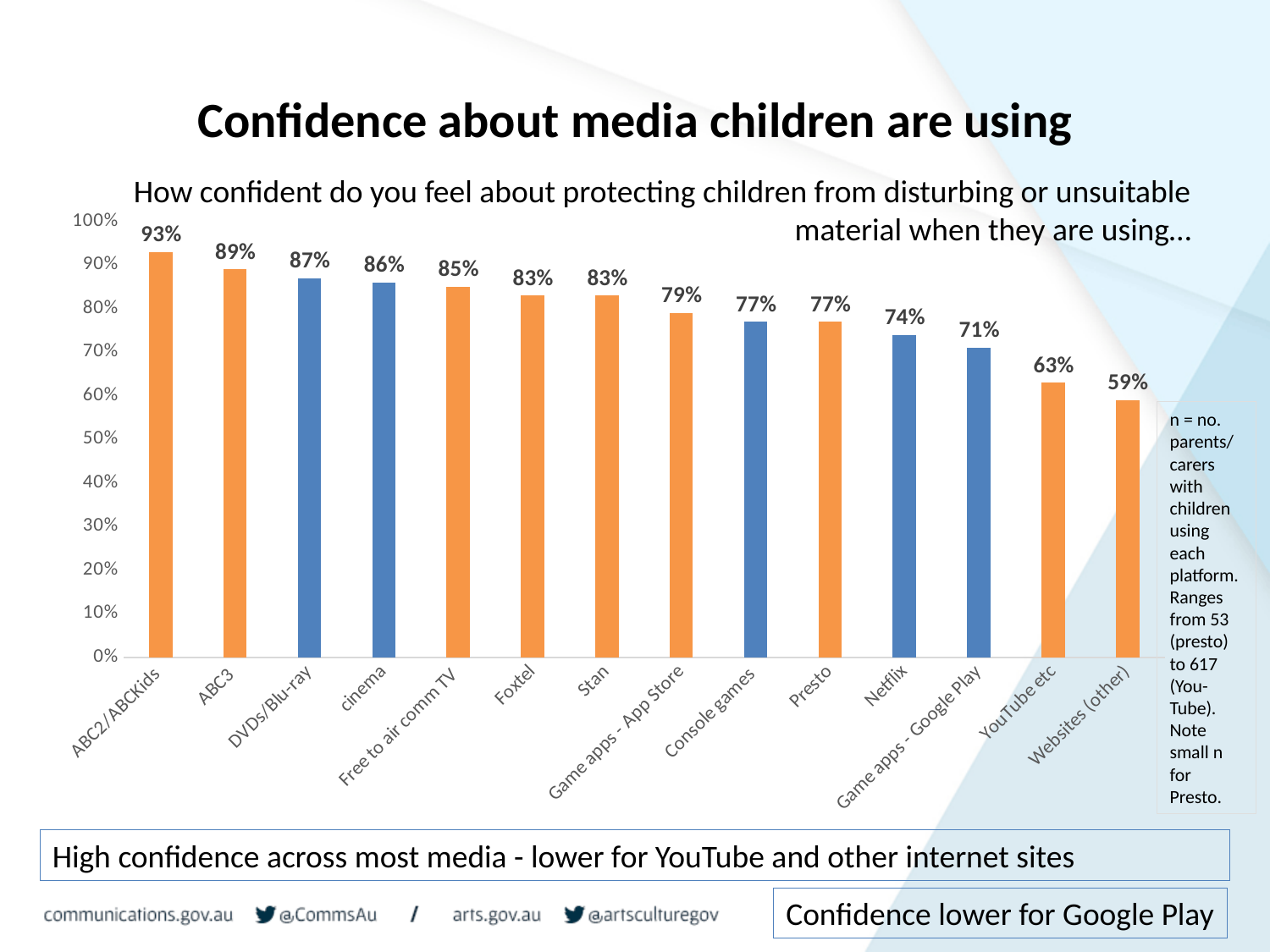
Which category has the lowest value? Websites (other) What is the value for Netflix? 74% What is the difference between the values for YouTube etc and Game apps - Google Play? 8% How many categories are shown on the x axis? 14 What kind of chart is shown on the slide? bar chart What is the value for ABC2/ABCKids? 93% Which category has the highest value? ABC2/ABCKids What is the value for Game apps - Google Play? 71% Which is larger, the value for cinema or the value for Foxtel? cinema Do the values generally rise or fall from left to right along the x axis? fall What is the title of the slide? Confidence about media children are using What is the difference between the values for ABC2/ABCKids and Websites (other)? 34%